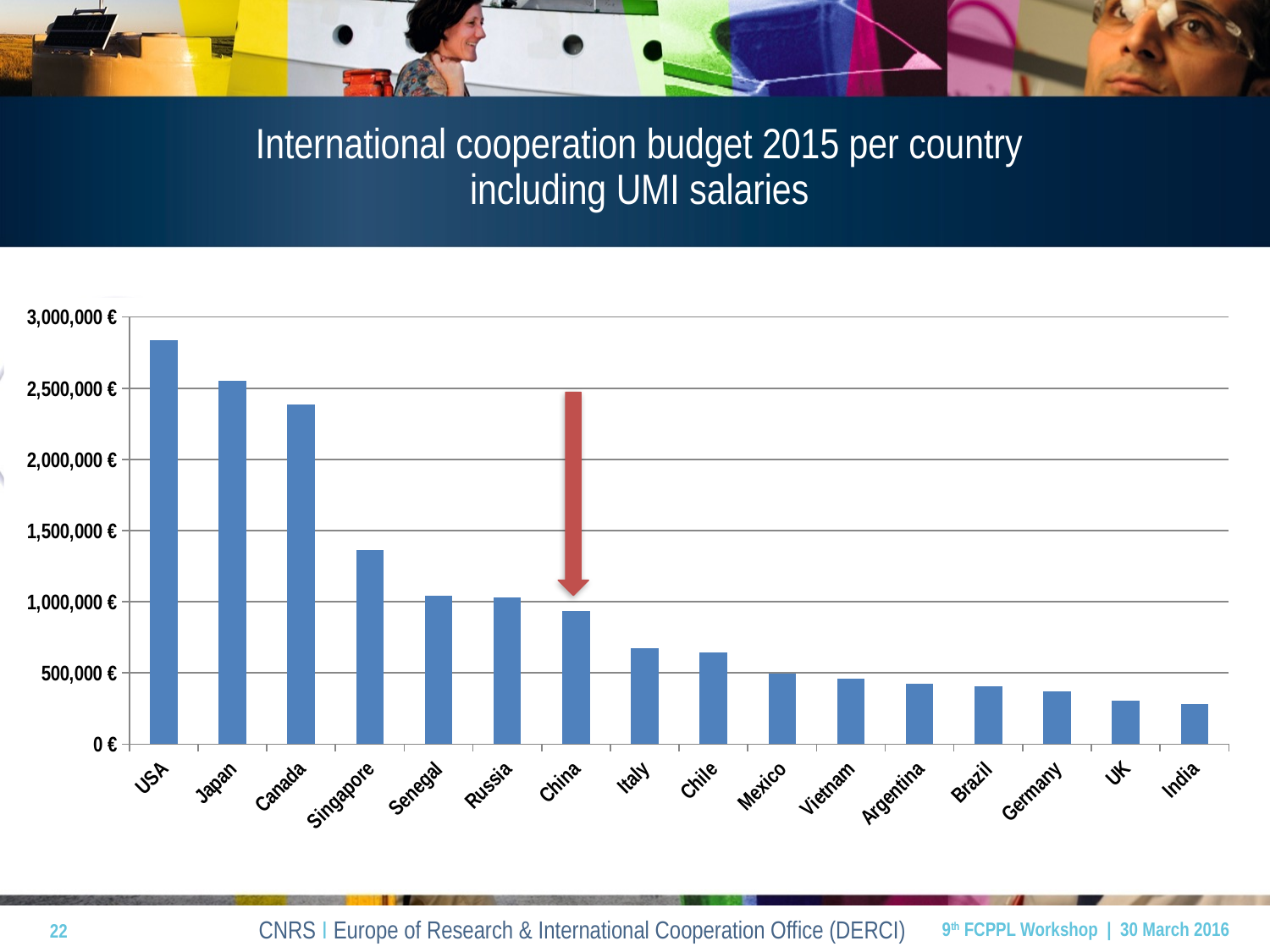
What kind of chart is shown on the slide? bar chart Is the value for Italy greater or less than 500,000 €? greater Which country has the lowest international cooperation budget in the chart? India Is the value for Germany greater or less than 500,000 €? less Which country has the highest international cooperation budget in the chart? USA Which has the larger budget, Singapore or China? Singapore How many countries are shown on the x axis of the chart? 16 Is the value for USA greater or less than 2,500,000 €? greater Do the values rise or fall moving from left to right along the x axis? fall